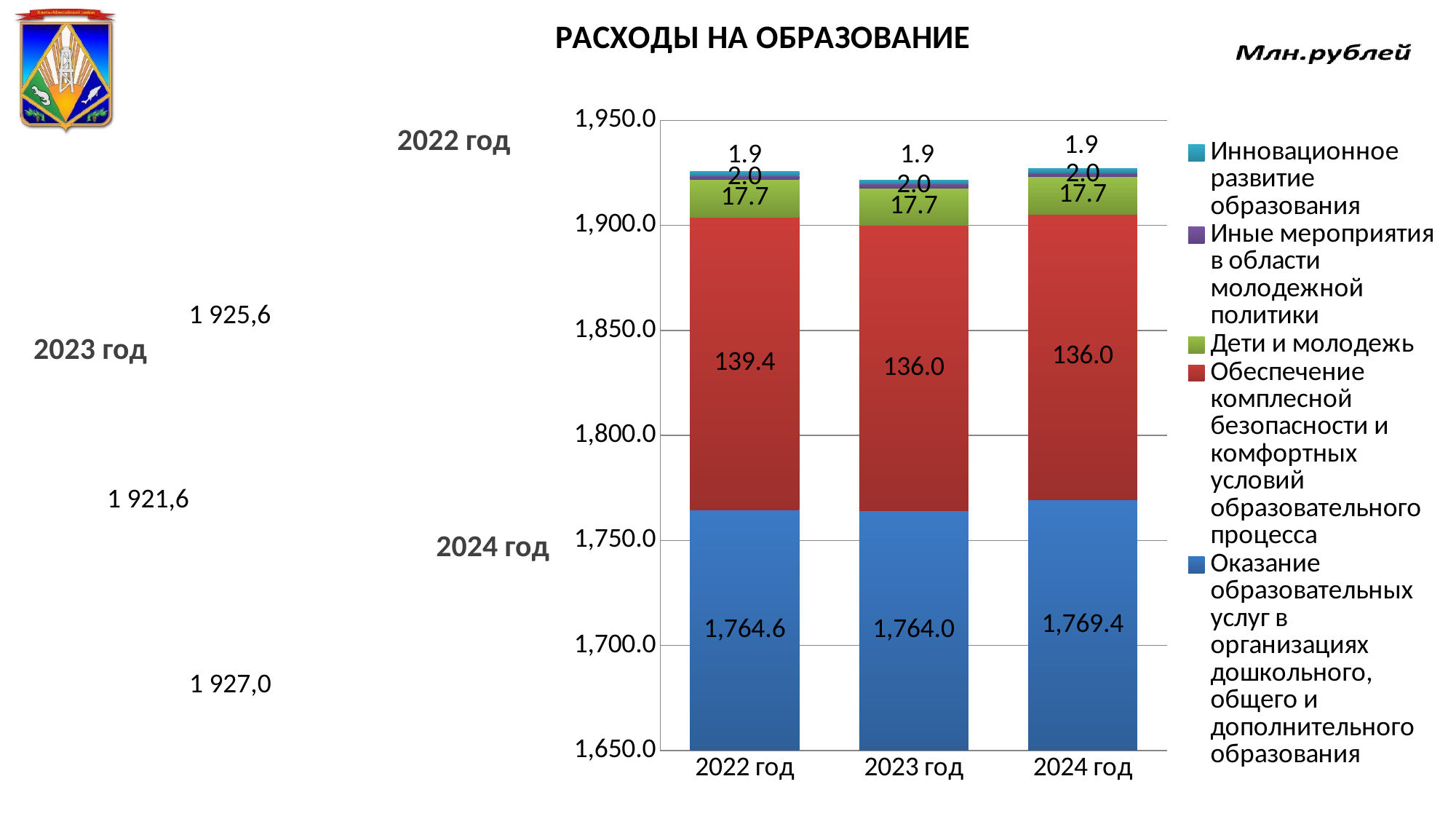
What is the value for Дети и молодежь in 2023 год? 17.7 How many years are shown on the x axis? 3 What is the difference between the Оказание образовательных услуг values for 2024 год and 2023 год? 5.4 What is the value for Оказание образовательных услуг in 2024 год? 1,769.4 How many series does the legend list? 5 What is the difference between the Обеспечение комплесной безопасности values for 2022 год and 2023 год? 3.4 What is the value for Обеспечение комплесной безопасности in 2022 год? 139.4 In which year is the value for Обеспечение комплесной безопасности the highest? 2022 год Which is larger: Оказание образовательных услуг in 2022 год or in 2023 год? 2022 год In which year is the value for Оказание образовательных услуг the highest? 2024 год What kind of chart is shown on the slide? Stacked bar chart What is the value for Инновационное развитие образования in 2022 год? 1.9